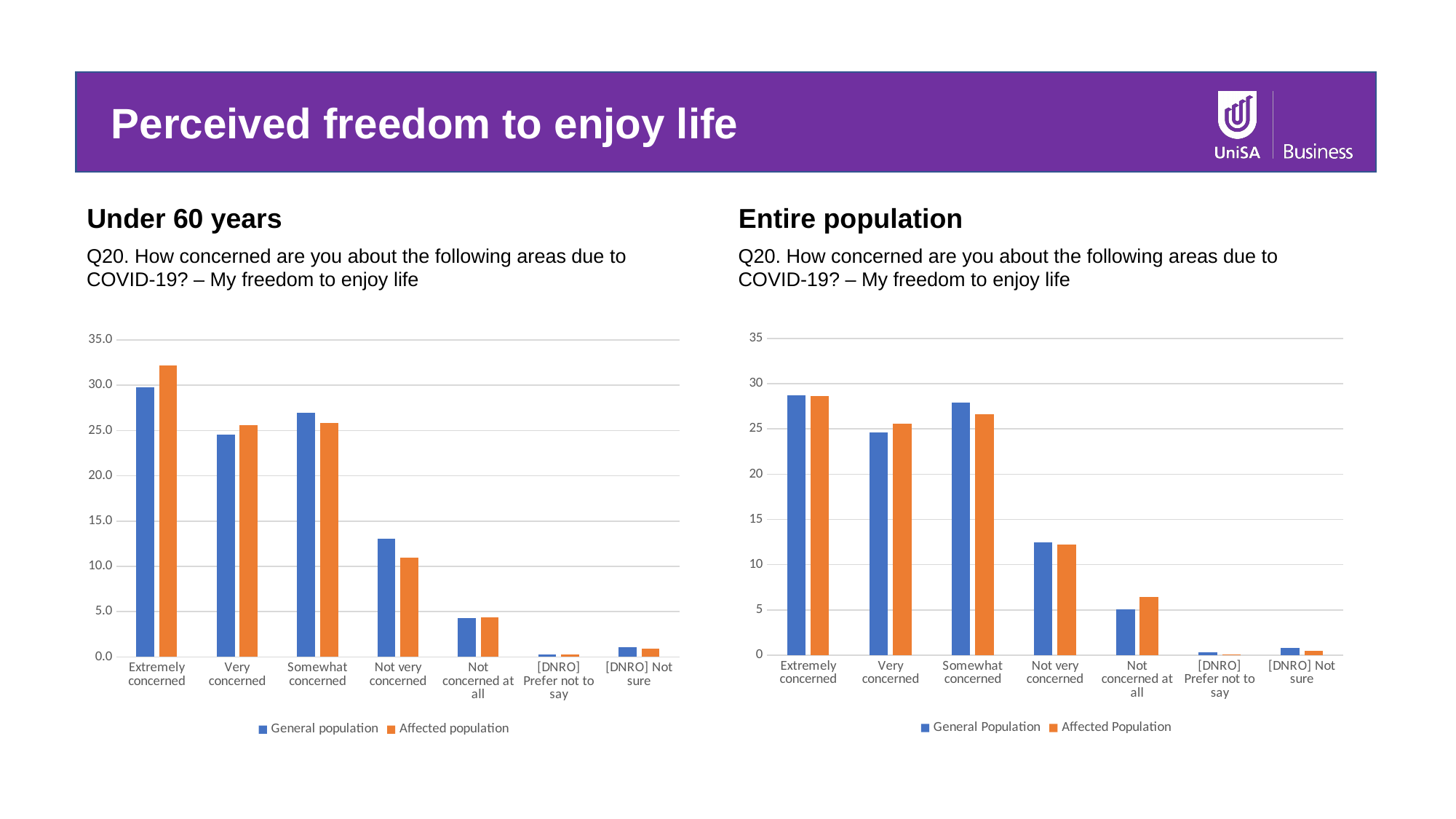
In the 'Under 60 years' chart, which category has the highest value for Affected population? Extremely concerned In the 'Entire population' chart, which category has the lowest value for Affected Population? [DNRO] Prefer not to say What kind of chart is the 'Under 60 years' chart on the left? Bar chart In the 'Entire population' chart, for Not concerned at all, which series has the larger value: General Population or Affected Population? Affected Population In the 'Entire population' chart, how many series does the legend list? 2 In the 'Entire population' chart, is the General Population value for Somewhat concerned greater or less than 25? greater In the 'Under 60 years' chart, how many response categories are shown on the x axis? 7 In the 'Under 60 years' chart, for Not very concerned, which series has the larger value: General population or Affected population? General population In the 'Entire population' chart, is the Affected Population value for Extremely concerned greater or less than 30? less In the 'Under 60 years' chart, is the General population value for Extremely concerned greater or less than 25.0? greater What are the two legend entries in the 'Entire population' chart? General Population and Affected Population